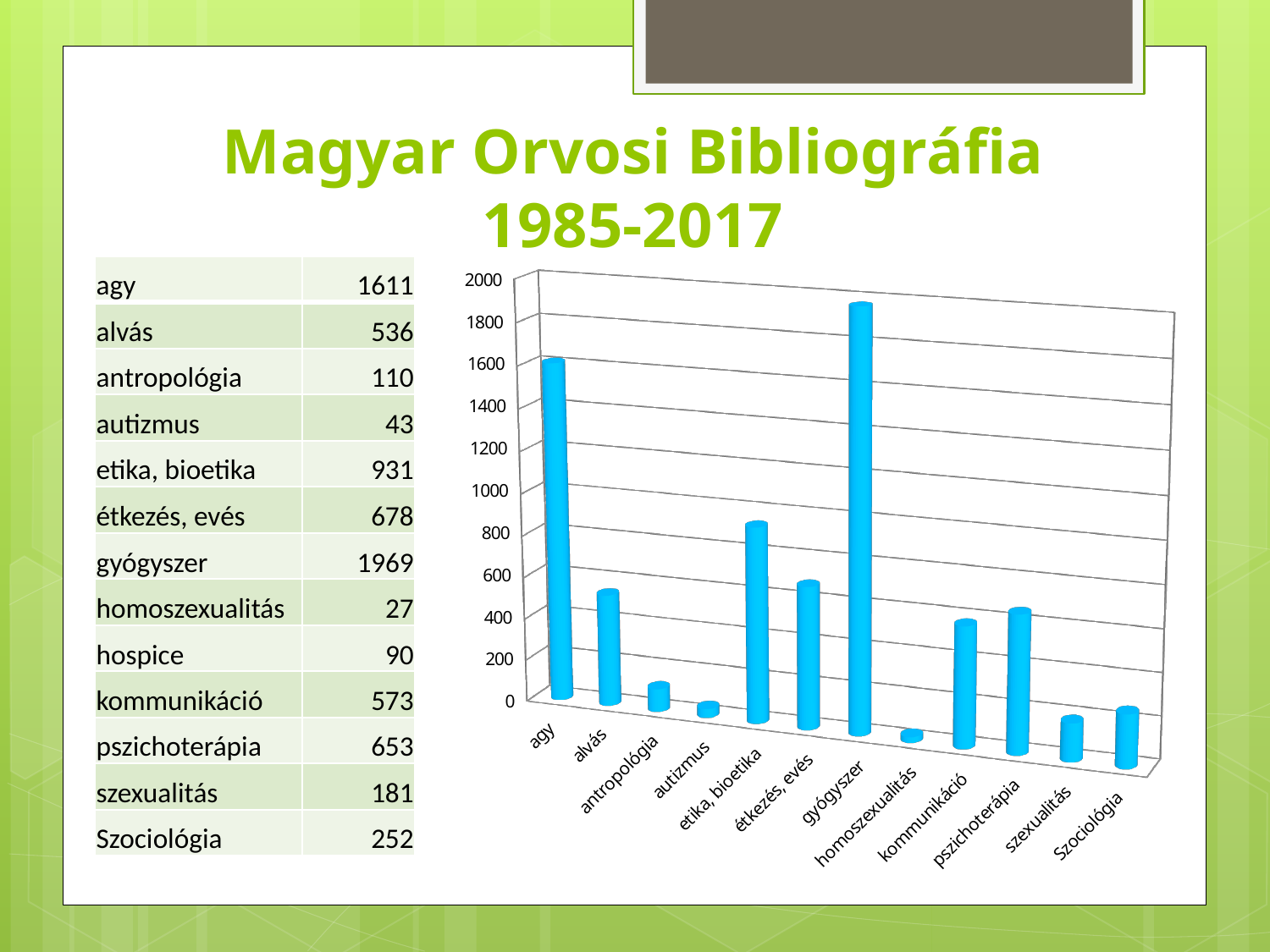
How many categories are plotted on the chart? 12 What is the value for etika, bioetika? 931 Which category has the lowest value on the chart? homoszexualitás What is the value for gyógyszer? 1969 Is the value for Szociológia greater or less than 400? less What is the difference between the values for gyógyszer and agy? 358 Which category has the highest value on the chart? gyógyszer Which is larger, the value for alvás or the value for kommunikáció? kommunikáció What is the title shown above the chart on the slide? Magyar Orvosi Bibliográfia 1985-2017 What kind of chart is shown on the slide? bar chart What is the value for agy? 1611 Is the value for etika, bioetika greater or less than 800? greater